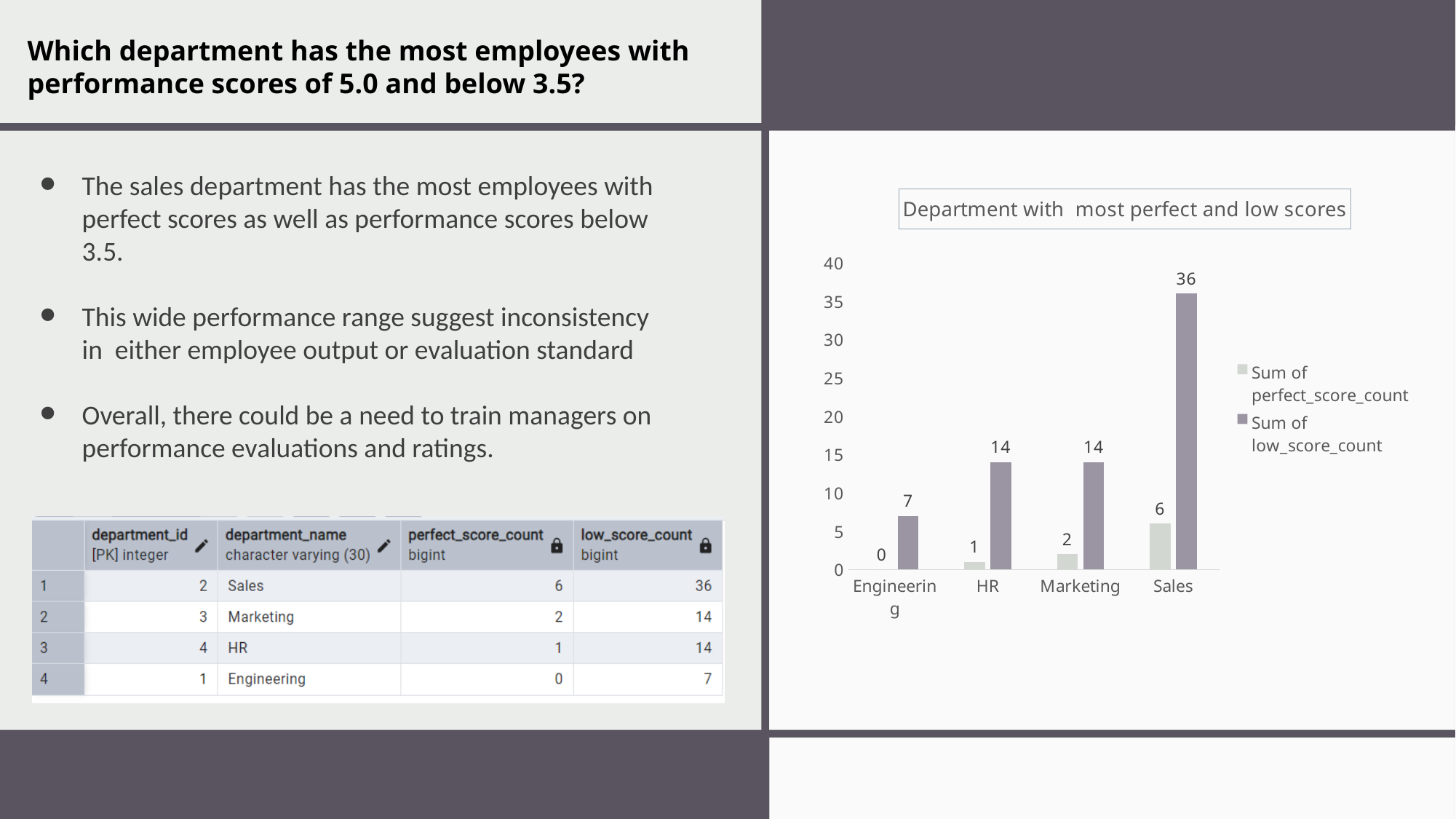
What is the title of the chart? Department with most perfect and low scores Which department has the lowest Sum of perfect_score_count? Engineering What is the Sum of low_score_count for Sales? 36 What kind of chart is shown on the slide? bar chart Which is larger, the Sum of perfect_score_count for Sales or for HR? Sales What is the difference between the Sum of low_score_count for Sales and for Engineering? 29 What is the Sum of perfect_score_count for Engineering? 0 What is the Sum of perfect_score_count for Marketing? 2 Is the Sum of low_score_count for Sales greater or less than 30? greater How many departments are shown on the x axis? 4 How many series does the legend list? 2 Which department has the highest Sum of low_score_count? Sales